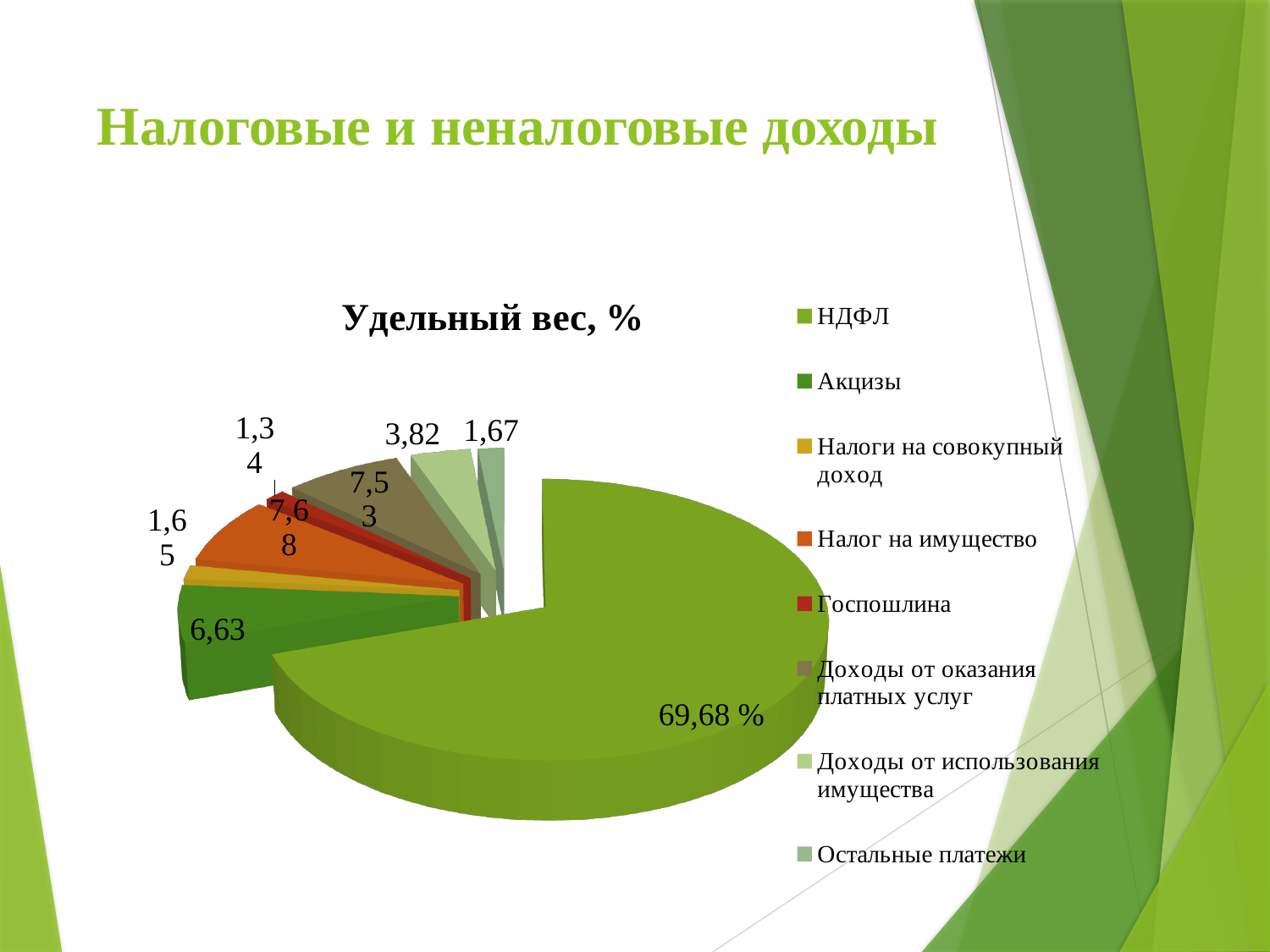
What is the value shown for Доходы от использования имущества? 3,82 What is the value shown for Остальные платежи? 1,67 What is the value shown for Акцизы? 6,63 What is the title of the chart? Удельный вес, % Which is larger, the slice for Акцизы or the slice for Доходы от использования имущества? Акцизы What is the value shown for Налог на имущество? 7,68 What is the difference between the values for Акцизы and Доходы от использования имущества? 2,81 What kind of chart is shown on the slide? pie chart How many entries does the chart legend list? 8 Which category has the largest slice of the pie? НДФЛ What is the value shown for НДФЛ? 69,68 % Which legend entry is shown in orange? Налог на имущество